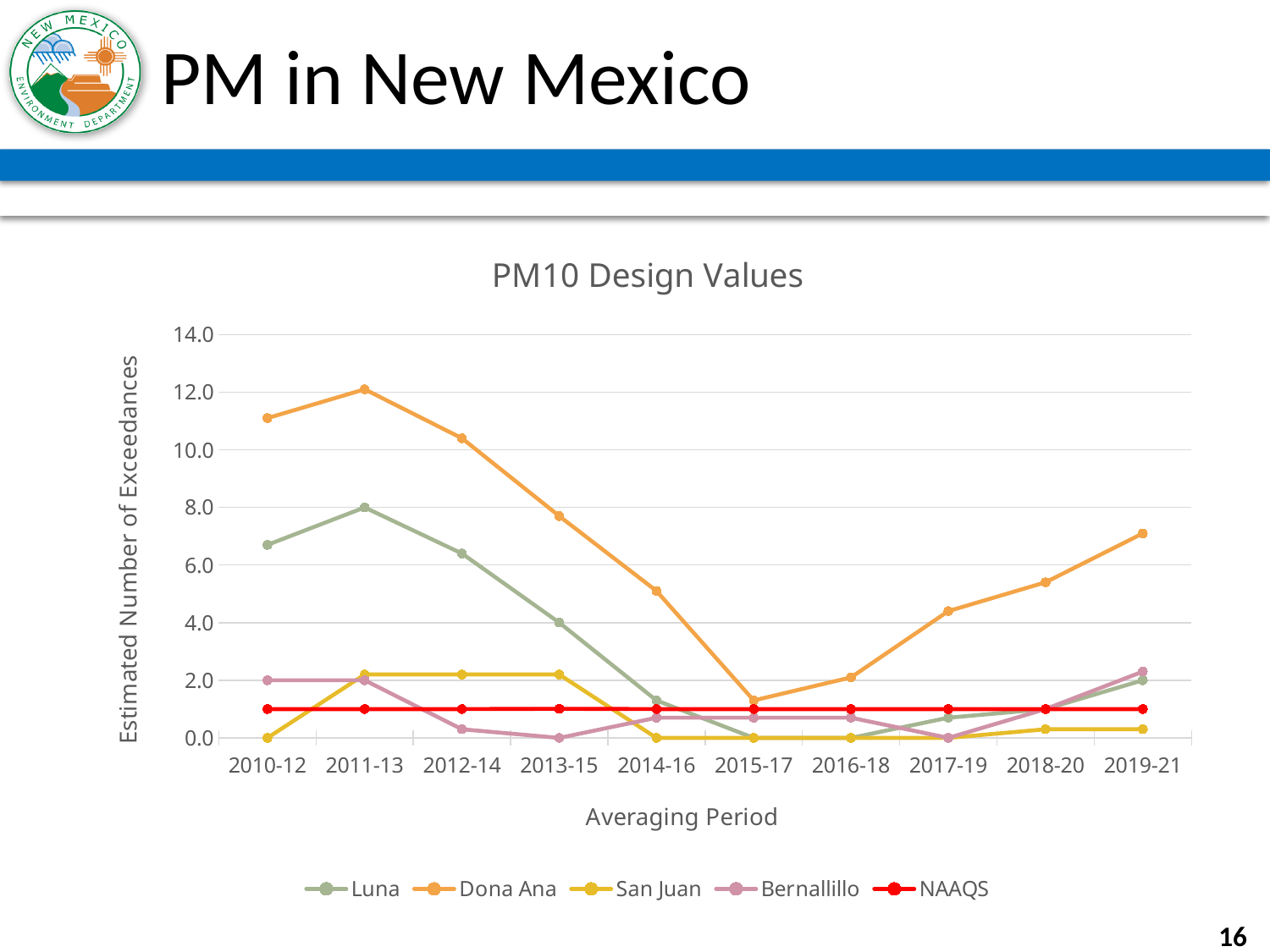
What is the San Juan value for 2015-17? 0.0 What kind of chart is shown on the slide? line chart Is the Dona Ana value for 2010-12 greater or less than 10.0? greater What is the y-axis label of the chart? Estimated Number of Exceedances How many series does the legend list? 5 In which averaging period does Dona Ana reach its lowest value? 2015-17 Which series has the larger value in 2010-12, Dona Ana or Luna? Dona Ana What is the Luna value for 2011-13? 8.0 Does the Dona Ana line rise or fall from 2015-17 to 2019-21? rise How many averaging periods are shown on the x axis? 10 What is the title of the chart? PM10 Design Values In which averaging period does Dona Ana reach its highest value? 2011-13